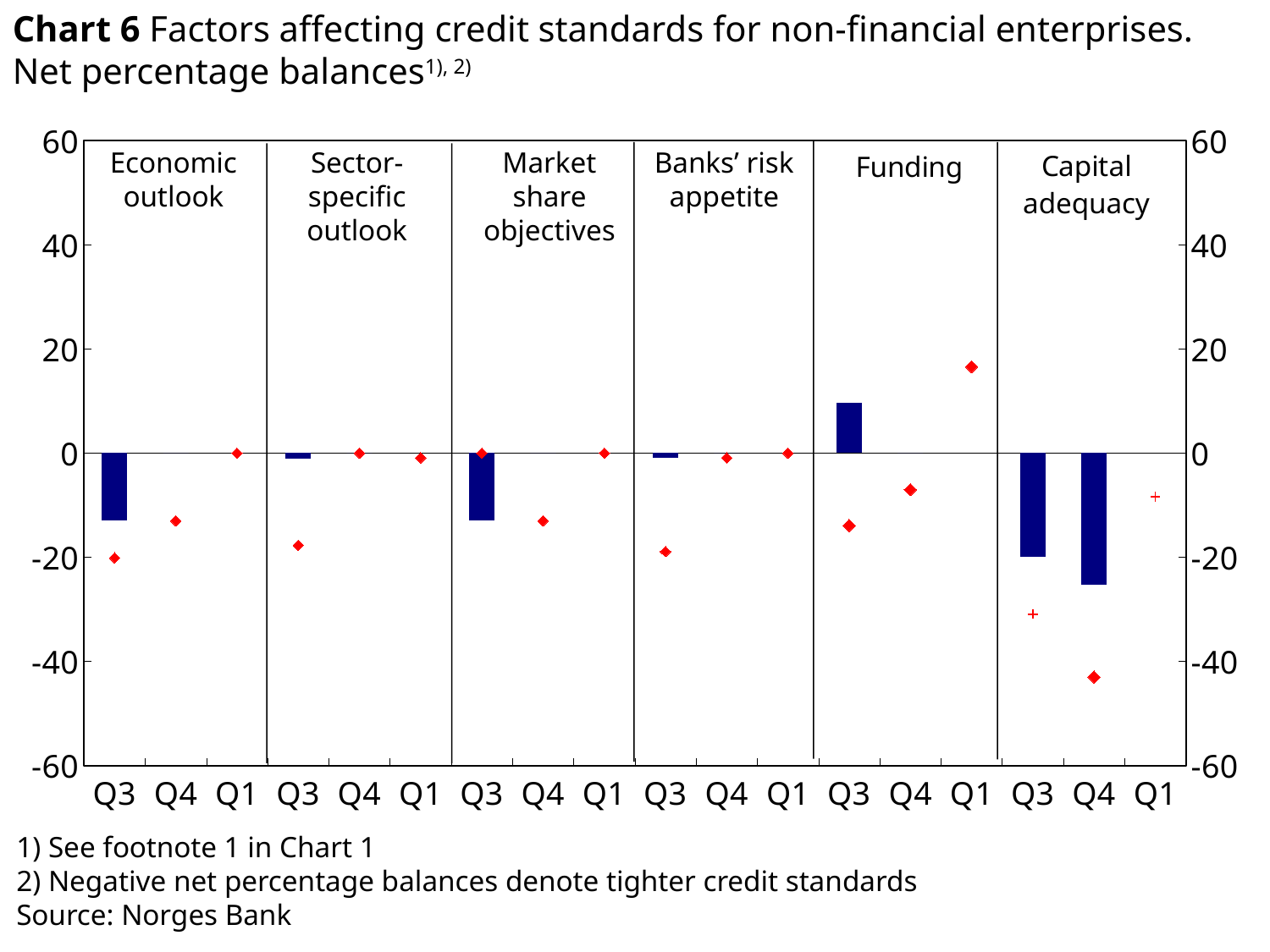
Is the Q3 bar for Economic outlook greater or less than -20? greater Is the Q4 bar for Capital adequacy greater or less than -20? less How many factors (panels) are shown in the chart? 6 Is the Q3 bar for Funding greater or less than 0? greater How many quarters are shown within each factor panel? 3 What kind of chart is shown on the slide? Combination bar and marker (line) chart Which factor is the only one with a positive (above zero) bar? Funding What is the source given for the chart? Norges Bank Which factor has the lowest bar in the chart? Capital adequacy Which Q3 bar is lower: Capital adequacy or Economic outlook? Capital adequacy